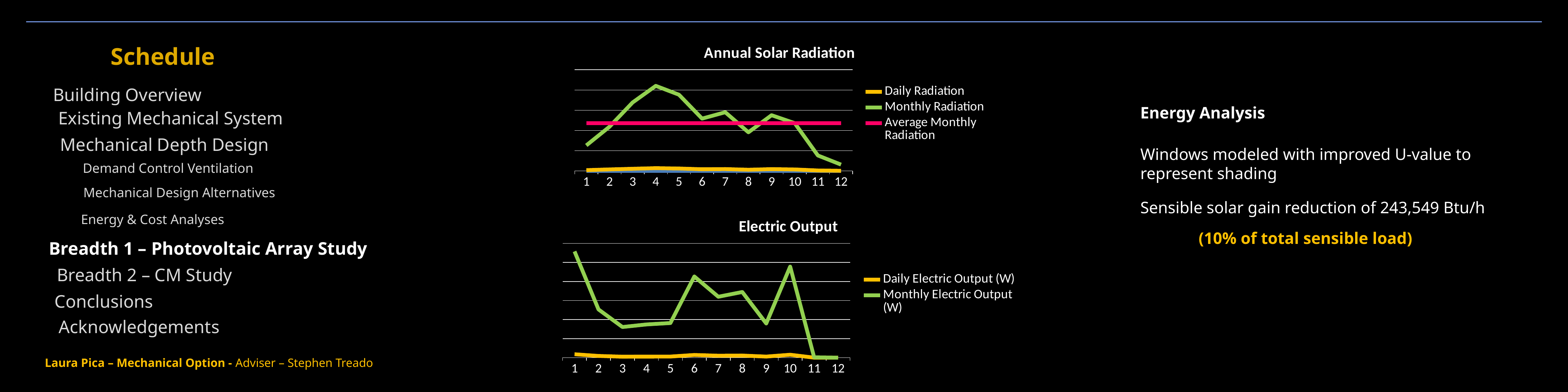
In the Annual Solar Radiation chart, does Monthly Radiation rise or fall from month 9 to month 12? fall How many series does the legend of the Electric Output chart list? 2 What kind of chart is the Annual Solar Radiation chart? line chart In the Annual Solar Radiation chart, at which month is Monthly Radiation highest? 4 In the Annual Solar Radiation chart, at which month is Monthly Radiation lowest? 12 In the Annual Solar Radiation chart, which series is drawn as a flat pink line? Average Monthly Radiation How many points are plotted along the x axis of the Annual Solar Radiation chart? 12 What kind of chart is the Electric Output chart? line chart In the Annual Solar Radiation chart, is Monthly Radiation larger at month 4 or month 8? month 4 In the Electric Output chart, is Monthly Electric Output (W) larger at month 3 or month 6? month 6 In the Electric Output chart, at which month is Monthly Electric Output (W) highest? 1 How many series does the legend of the Annual Solar Radiation chart list? 3